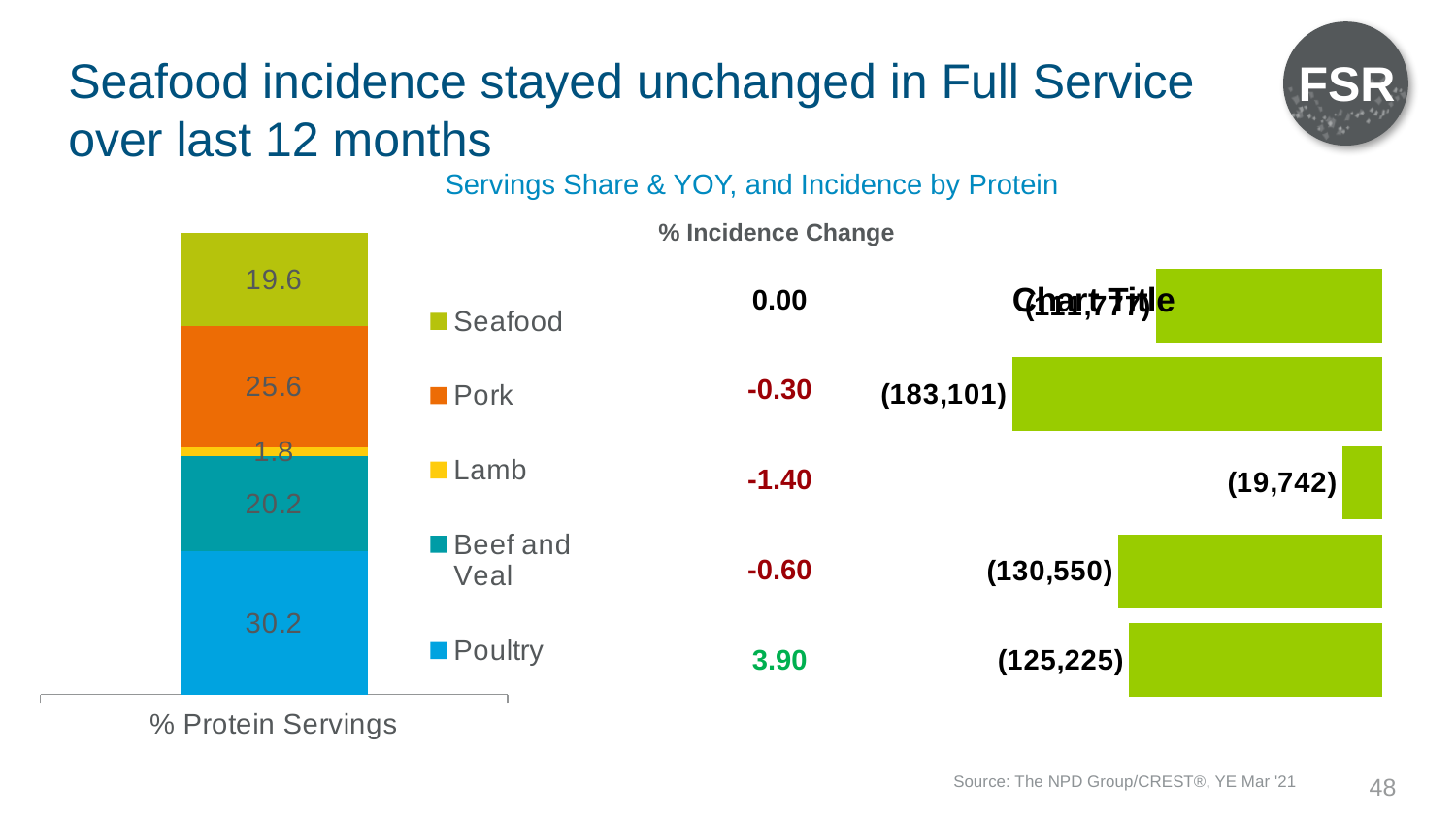
In the stacked bar chart labelled % Protein Servings, which is larger, Beef and Veal or Seafood? Beef and Veal In the stacked bar chart labelled % Protein Servings, what is the value for Pork? 25.6 In the stacked bar chart labelled % Protein Servings, what is the value for Poultry? 30.2 In the stacked bar chart labelled % Protein Servings, what is the difference between the Poultry and Seafood values? 10.6 In the green bar chart on the right, which row has the shortest bar? Lamb In the stacked bar chart labelled % Protein Servings, which protein has the smallest share? Lamb What kind of chart is the % Protein Servings chart on the left? Stacked bar chart In the stacked bar chart labelled % Protein Servings, which protein has the largest share? Poultry In the stacked bar chart labelled % Protein Servings, what is the value for Lamb? 1.8 In the % Incidence Change column, what is the value for Poultry? 3.90 In the green bar chart on the right, what is the value shown for the Pork row? (183,101) How many entries does the legend of the % Protein Servings chart list? 5